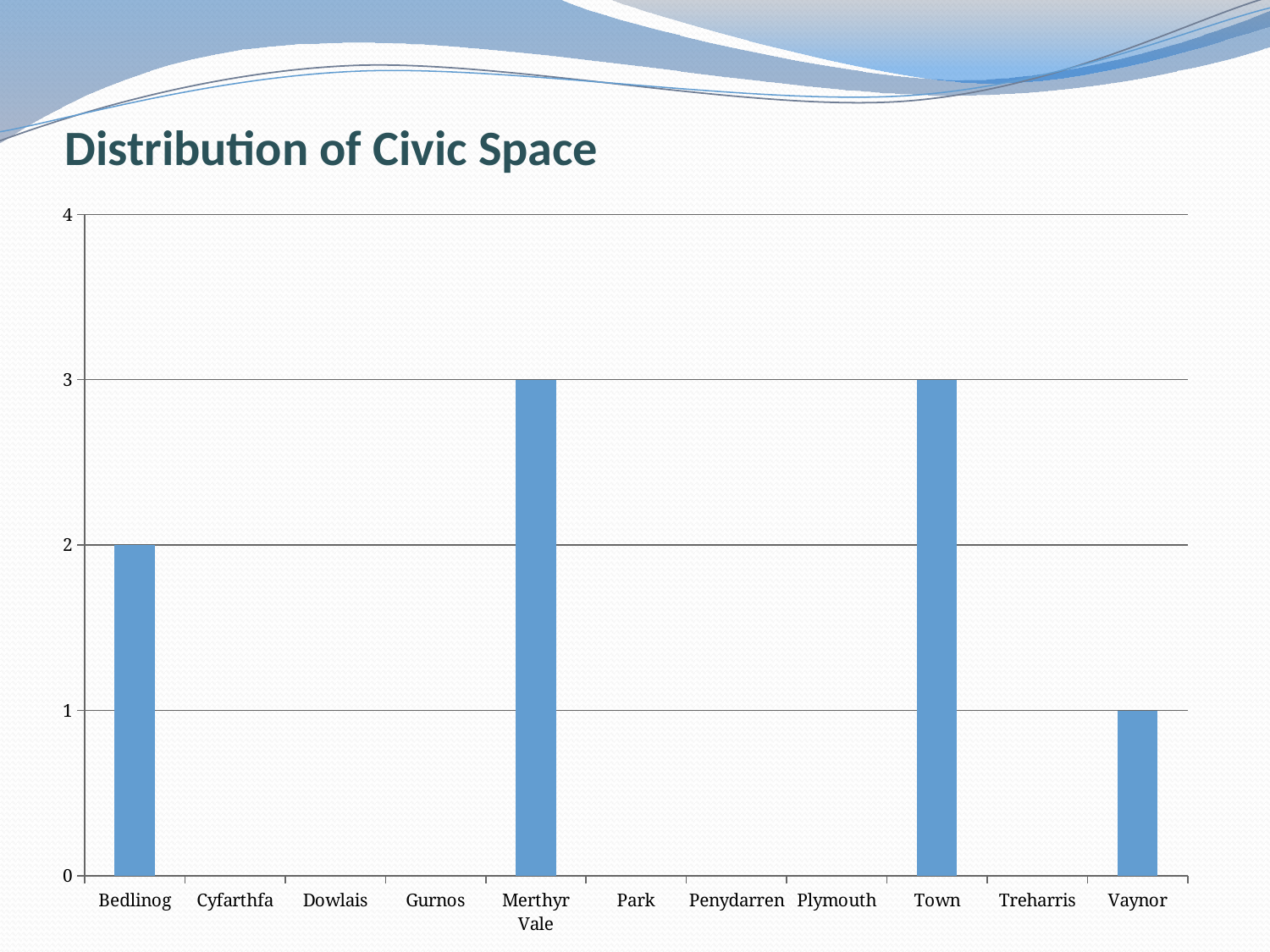
What is the difference between the value for Merthyr Vale and the value for Vaynor? 2 How many categories are shown on the x axis? 11 Is the value for Bedlinog greater or less than 3? less What type of chart is shown on the slide? Bar chart Which is larger, the value for Bedlinog or the value for Vaynor? Bedlinog What is the value for Merthyr Vale? 3 Which is larger, the value for Town or the value for Bedlinog? Town What is the value for Bedlinog? 2 What is the value for Town? 3 What is the value for Vaynor? 1 What is the title of the chart? Distribution of Civic Space